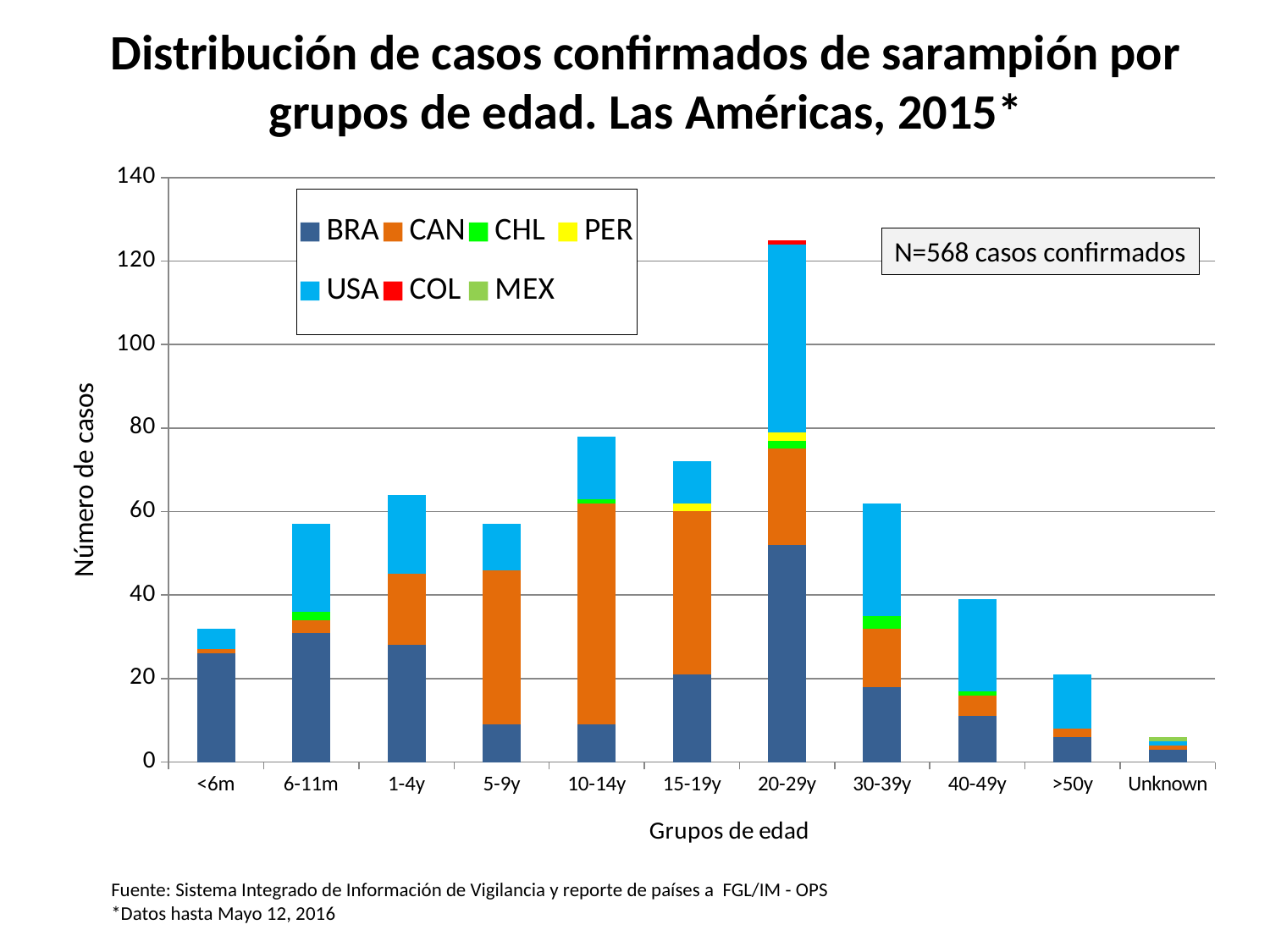
Is the total number of cases for the Unknown group greater or less than 20? less Is the total number of cases for the 20-29y group greater or less than 120? greater According to the text box on the chart, how many confirmed cases are included (N)? N=568 casos confirmados How many series does the legend list? 7 Do the total bar heights rise or fall from the 20-29y group to the >50y group? fall How many age groups are shown along the x axis? 11 Is the total number of cases for the >50y group greater or less than 40? less What kind of chart is shown on the slide? Stacked bar chart Which age group has the highest total number of confirmed cases? 20-29y Which age group has a taller bar, 20-29y or 30-39y? 20-29y Which age group has the lowest total number of confirmed cases? Unknown